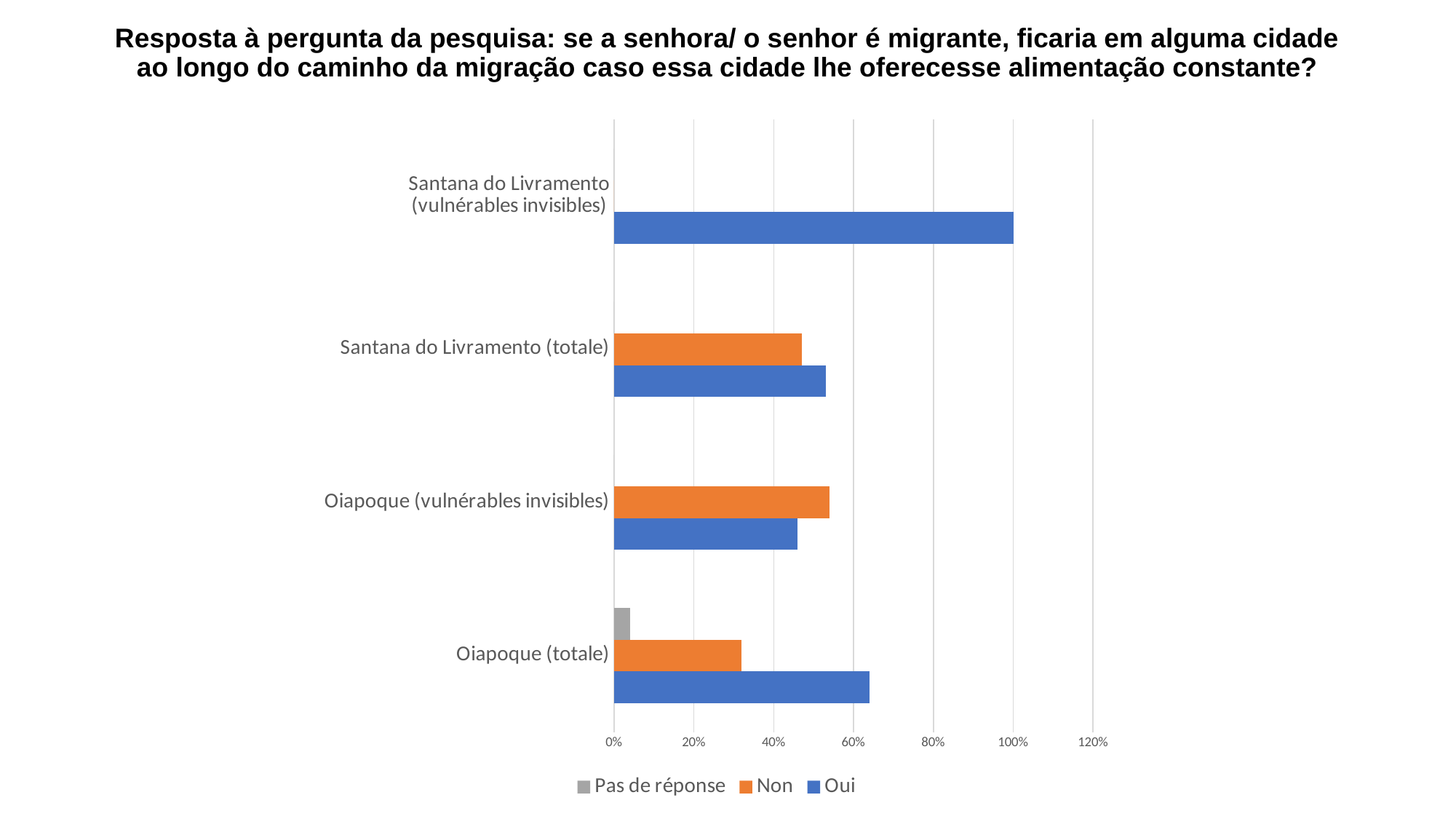
Which category is the only one with a Pas de réponse bar? Oiapoque (totale) Is the value of Non for Oiapoque (totale) greater or less than 40%? less Is the value of Pas de réponse for Oiapoque (totale) greater or less than 20%? less For Oiapoque (vulnérables invisibles), which is larger, Non or Oui? Non What kind of chart is shown on the slide? bar chart Which category has the highest value for Oui? Santana do Livramento (vulnérables invisibles) For Oiapoque (totale), which is larger, Oui or Non? Oui What is the value of Oui for Santana do Livramento (vulnérables invisibles)? 100% How many categories are shown on the chart? 4 Is the value of Non for Santana do Livramento (totale) greater or less than 60%? less How many series does the legend list? 3